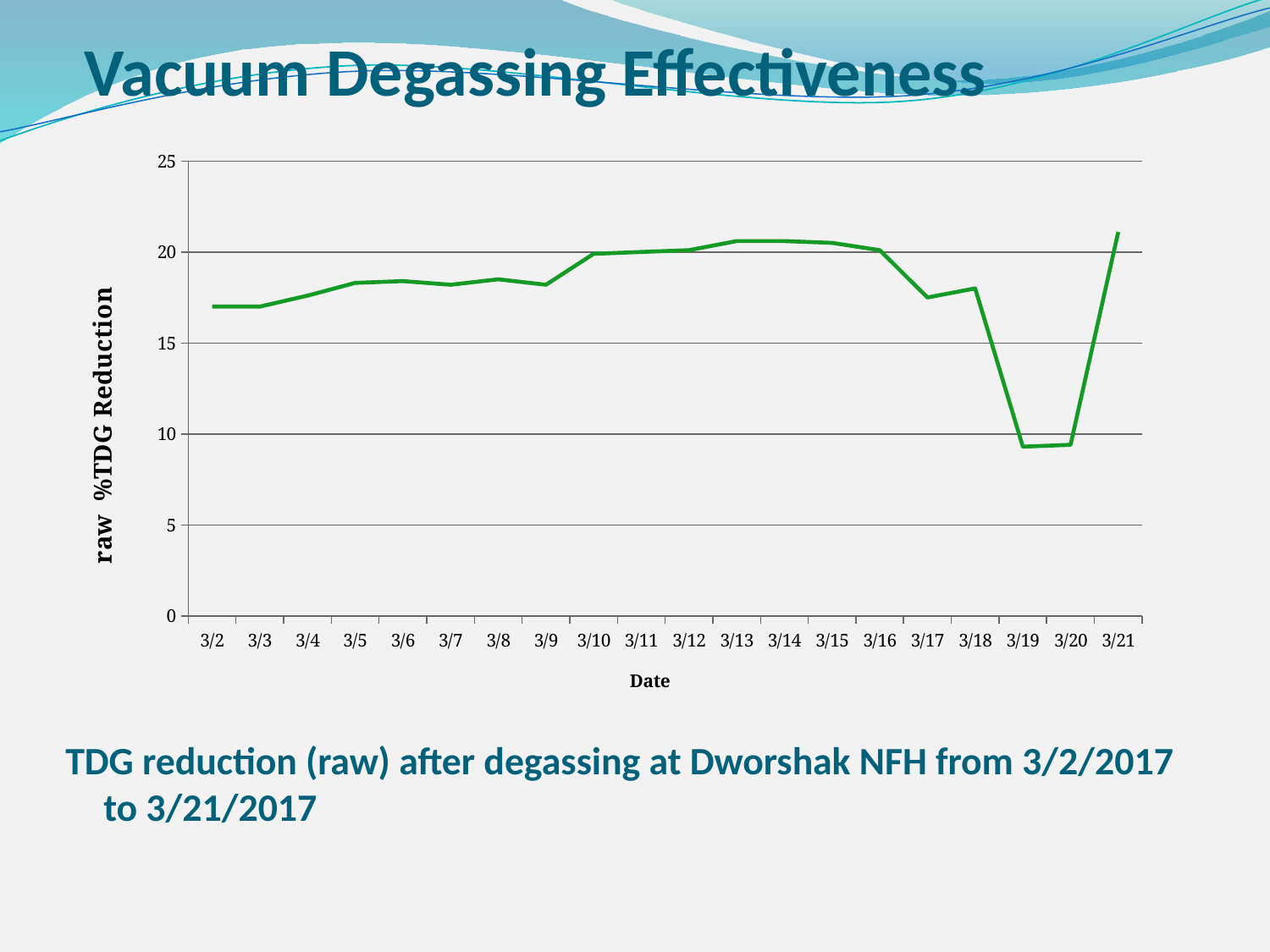
Is the value for 3/21 greater or less than 20? greater What is the label on the x axis? Date Is the value for 3/17 greater or less than 20? less Is the value for 3/20 greater or less than 15? less Do the values rise or fall from 3/16 to 3/19? fall What is the label on the y axis? raw %TDG Reduction What kind of chart is shown on the slide? line chart How many dates are plotted along the x axis? 20 Which is larger, the value for 3/13 or the value for 3/19? 3/13